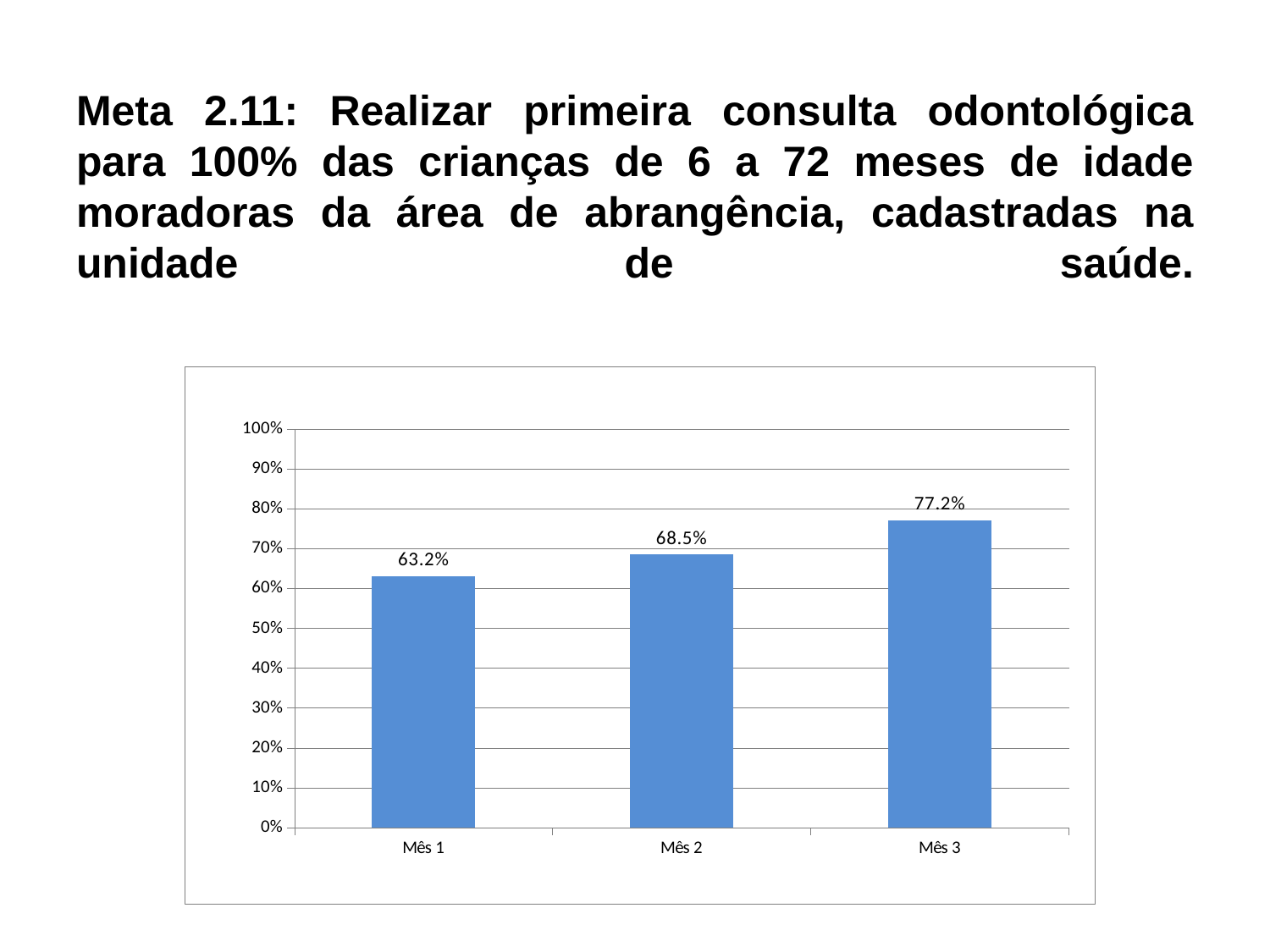
What is the difference between the values for Mês 3 and Mês 1? 14.0% What is the difference between the values for Mês 2 and Mês 1? 5.3% What is the value for Mês 2? 68.5% Which is larger, the value for Mês 2 or the value for Mês 3? Mês 3 What is the value for Mês 1? 63.2% Which month has the lowest value? Mês 1 What kind of chart is shown on the slide? bar chart Which month has the highest value? Mês 3 Is the value for Mês 1 greater or less than 70%? less Do the values rise or fall from Mês 1 to Mês 3? rise How many categories are shown on the x axis? 3 What is the value for Mês 3? 77.2%